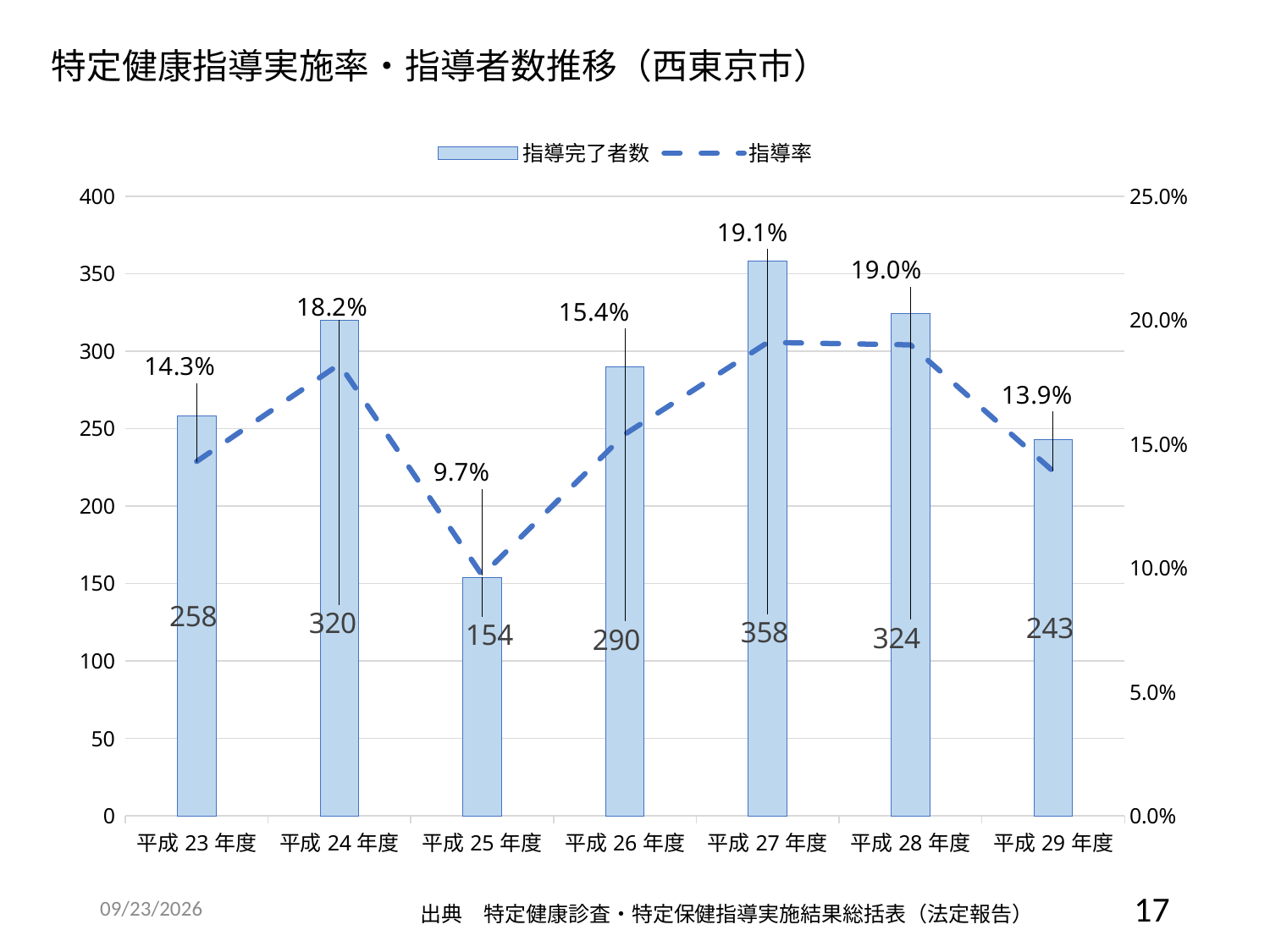
What is the 指導率 value for 平成 27 年度? 19.1% How many years are shown on the x axis? 7 Which year has the highest 指導完了者数? 平成 27 年度 Is the 指導完了者数 for 平成 26 年度 greater or less than 250? greater What is the 指導完了者数 value for 平成 25 年度? 154 What kind of chart is used for the 指導完了者数 series? bar chart What is the 指導完了者数 value for 平成 29 年度? 243 Which year has the lowest 指導率? 平成 25 年度 How many series does the legend list? 2 What is the difference in 指導完了者数 between 平成 27 年度 and 平成 25 年度? 204 What is the title of the slide? 特定健康指導実施率・指導者数推移（西東京市） Which is larger, the 指導完了者数 for 平成 24 年度 or for 平成 28 年度? 平成 28 年度